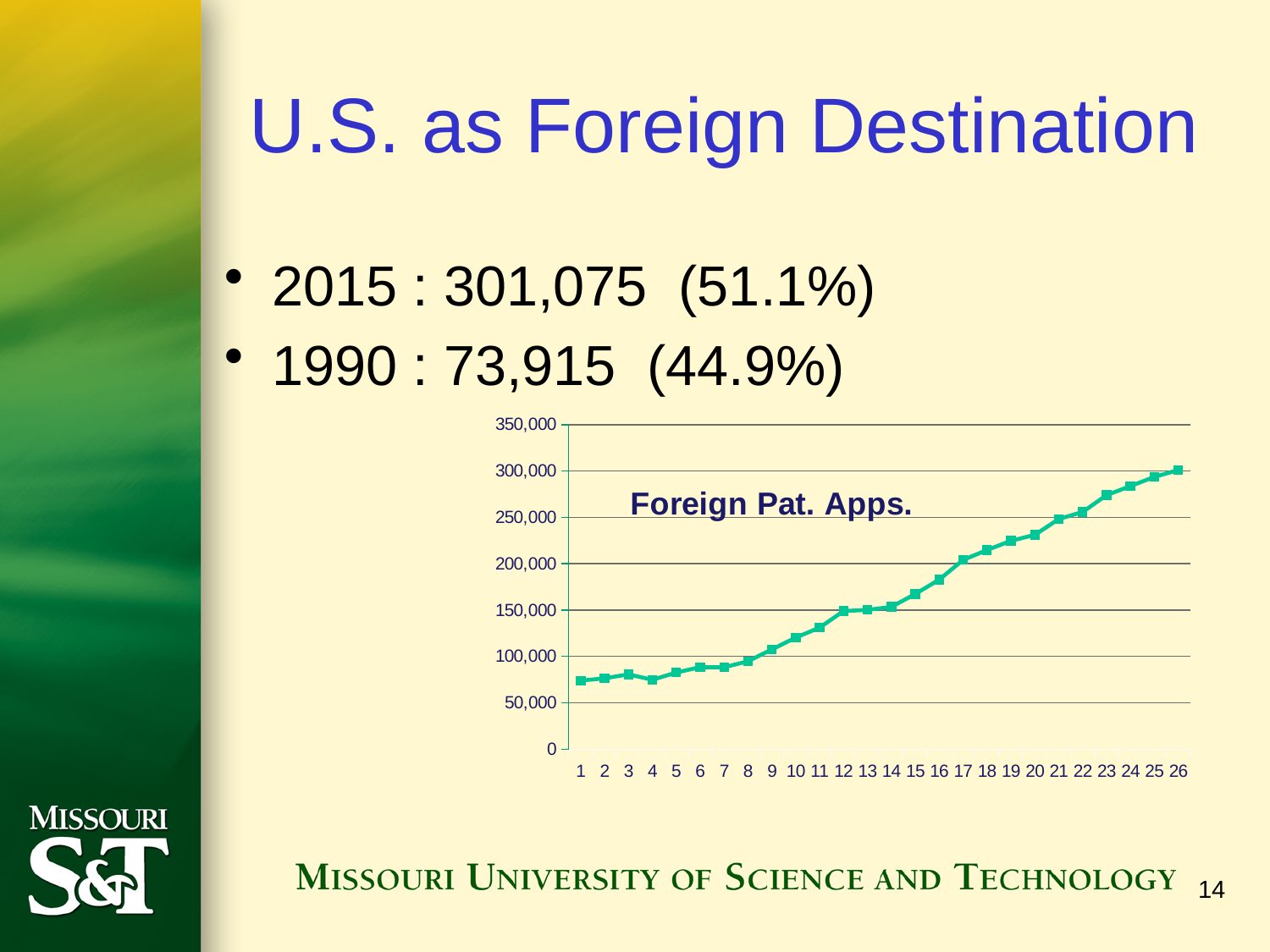
Is the value at point 26 greater or less than 250,000? greater What is the highest value shown on the chart's y axis? 350,000 Do the values in the chart generally rise or fall from point 1 to point 26? rise Which has the larger value in the chart, point 10 or point 20? point 20 Is the value at point 1 greater or less than 100,000? less What kind of chart is shown on the slide? line chart Which x-axis point has the highest value in the chart? 26 Is the value at point 12 greater or less than 200,000? less How many data points are plotted along the x axis of the chart? 26 What is the label of the series plotted in the chart? Foreign Pat. Apps.